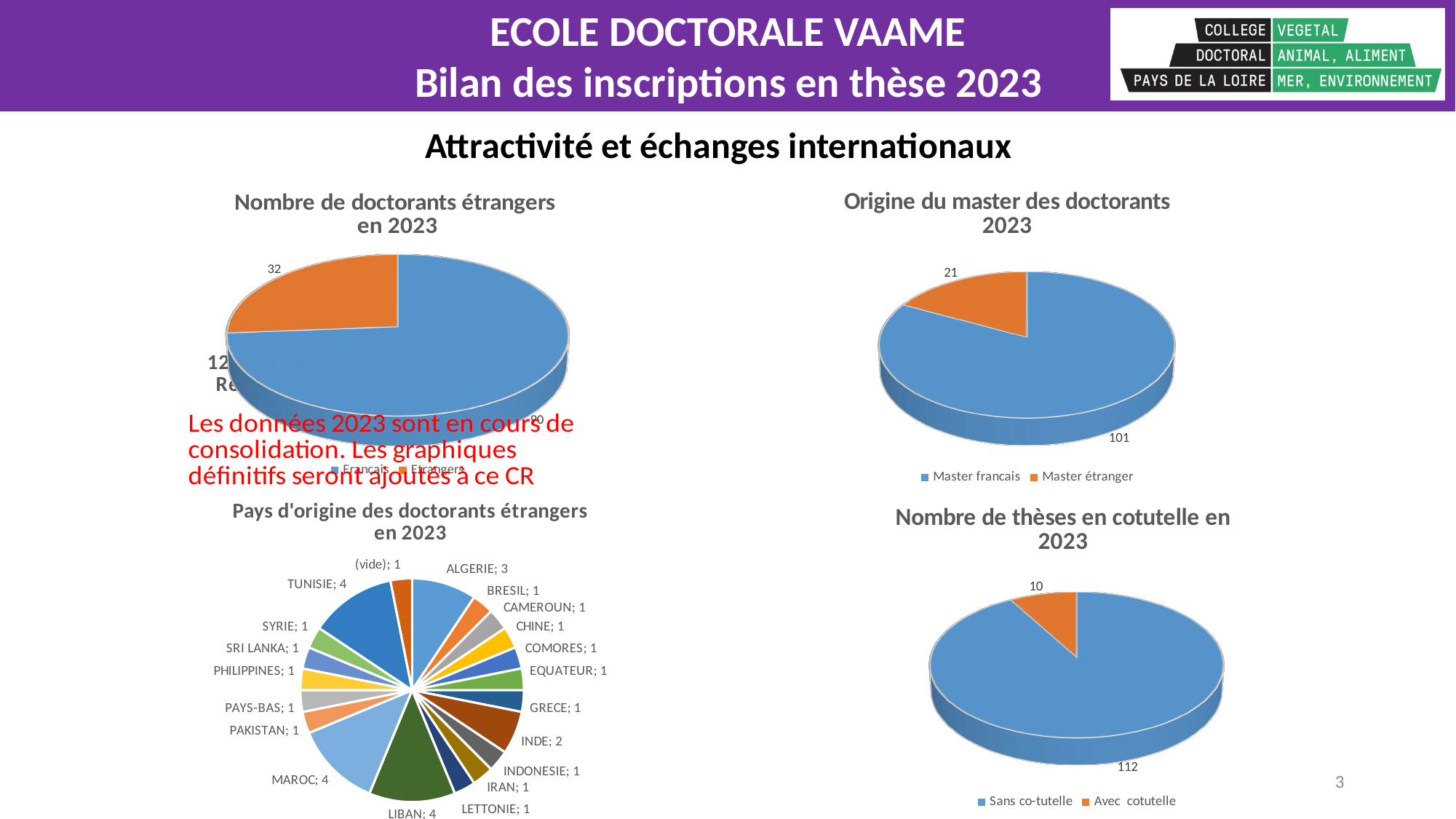
In the chart 'Pays d'origine des doctorants étrangers en 2023', what is the value for MAROC? 4 In the chart 'Nombre de thèses en cotutelle en 2023', what is the value for Avec cotutelle? 10 In the chart 'Nombre de thèses en cotutelle en 2023', what is the value for Sans co-tutelle? 112 In the chart 'Pays d'origine des doctorants étrangers en 2023', what is the value for INDE? 2 What kind of chart is 'Nombre de thèses en cotutelle en 2023'? Pie chart In the chart 'Pays d'origine des doctorants étrangers en 2023', how many categories are shown? 20 In the chart 'Origine du master des doctorants 2023', which category is larger, Master français or Master étranger? Master français In the chart 'Nombre de doctorants étrangers en 2023', what is the value for Etrangers? 32 In the chart 'Origine du master des doctorants 2023', what is the value for Master français? 101 In the chart 'Nombre de thèses en cotutelle en 2023', what is the difference between Sans co-tutelle and Avec cotutelle? 102 In the chart 'Origine du master des doctorants 2023', what is the value for Master étranger? 21 How many entries does the legend of the chart 'Origine du master des doctorants 2023' list? 2